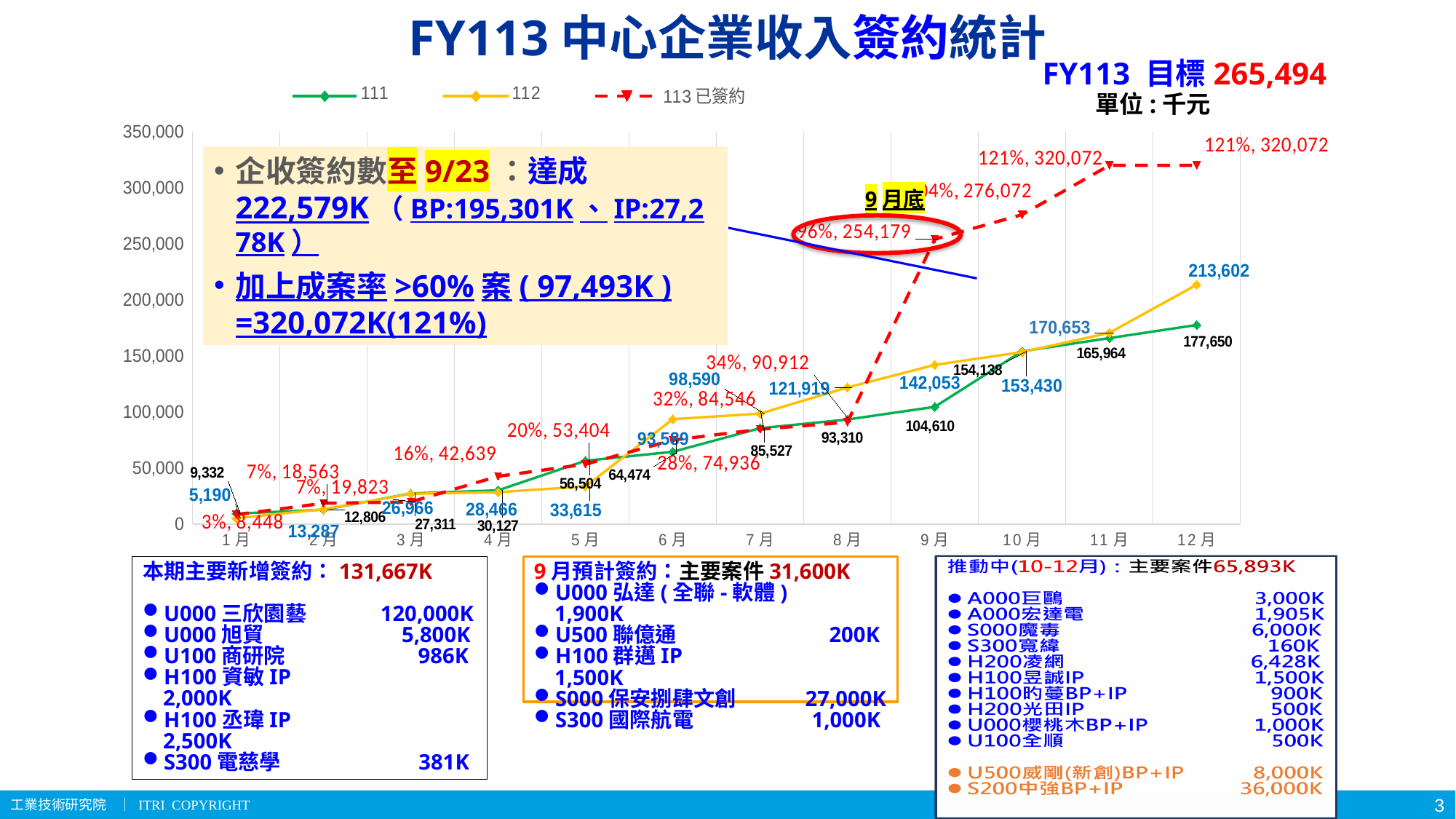
What is the value of the 113 已簽約 series at 11月? 320,072 What is the value of series 112 at 12月? 213,602 What is the difference between series 112 and series 111 at 12月? 35,952 How many months are shown along the x axis of the chart? 12 What is the value of series 112 at 8月? 121,919 How many series does the chart legend list? 3 Which series has the highest value at 12月? 113 已簽約 What kind of chart is shown on the slide? line chart What is the value of series 111 at 12月? 177,650 At 12月, which is larger: series 111 or series 112? 112 What FY113 target value (目標) is stated on the slide? 265,494 What is the value of series 111 at 9月? 104,610